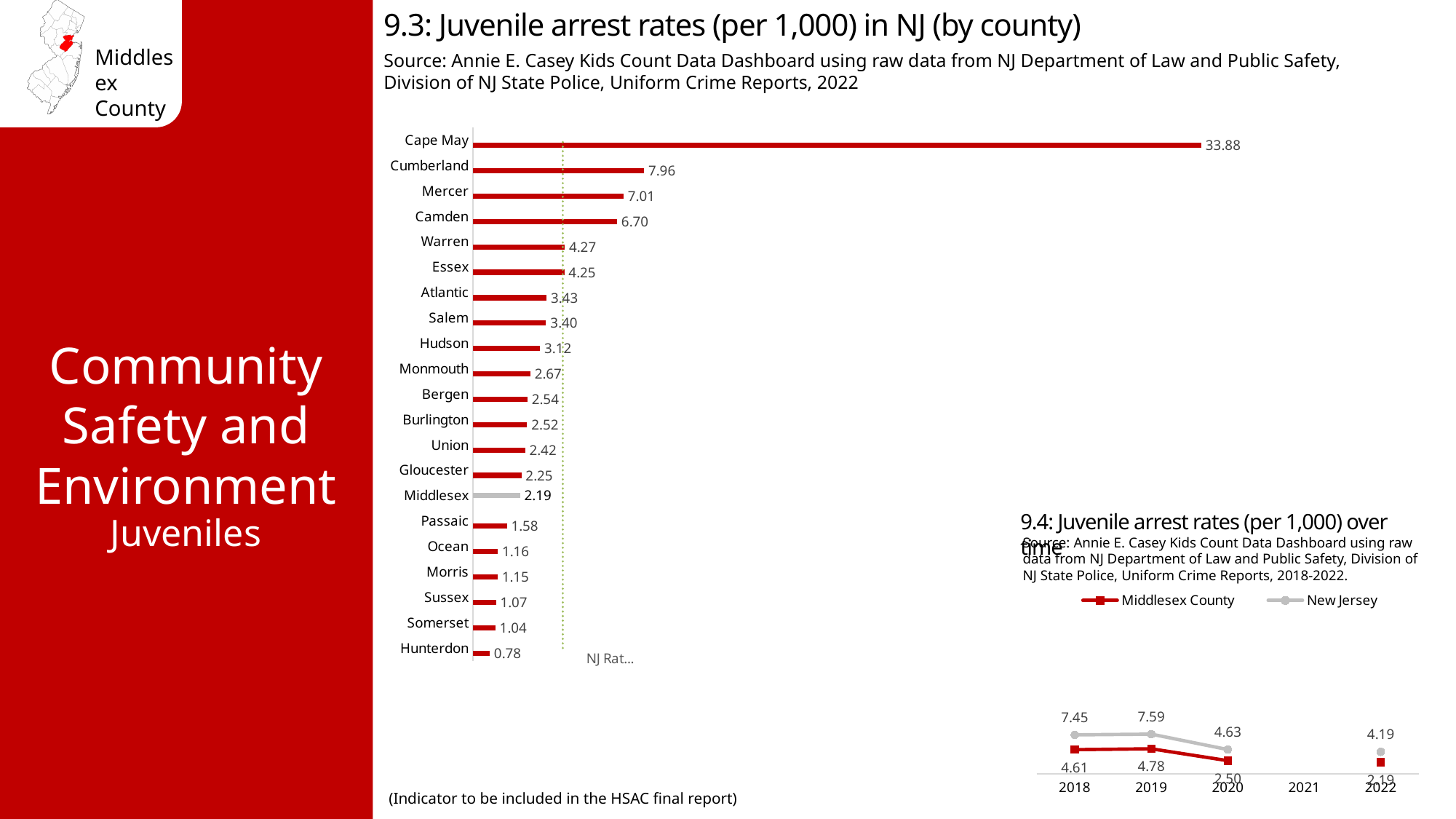
In the chart '9.3: Juvenile arrest rates (per 1,000) in NJ (by county)', what is the value for Cape May? 33.88 In the chart '9.3: Juvenile arrest rates (per 1,000) in NJ (by county)', how many counties are shown? 21 In the chart '9.3: Juvenile arrest rates (per 1,000) in NJ (by county)', which has a higher value, Camden or Warren? Camden What kind of chart is '9.3: Juvenile arrest rates (per 1,000) in NJ (by county)'? Bar chart In the chart '9.4: Juvenile arrest rates (per 1,000) over time', what is the value for New Jersey in 2019? 7.59 In the chart '9.4: Juvenile arrest rates (per 1,000) over time', what is the difference between the New Jersey and Middlesex County values in 2018? 2.84 In the chart '9.3: Juvenile arrest rates (per 1,000) in NJ (by county)', what is the value for Middlesex? 2.19 In the chart '9.4: Juvenile arrest rates (per 1,000) over time', how many series does the legend list? 2 In the chart '9.3: Juvenile arrest rates (per 1,000) in NJ (by county)', which county has the lowest juvenile arrest rate? Hunterdon In the chart '9.3: Juvenile arrest rates (per 1,000) in NJ (by county)', which county has the highest juvenile arrest rate? Cape May In the chart '9.4: Juvenile arrest rates (per 1,000) over time', what is the value for Middlesex County in 2022? 2.19 In the chart '9.3: Juvenile arrest rates (per 1,000) in NJ (by county)', what is the difference between the values for Cumberland and Mercer? 0.95